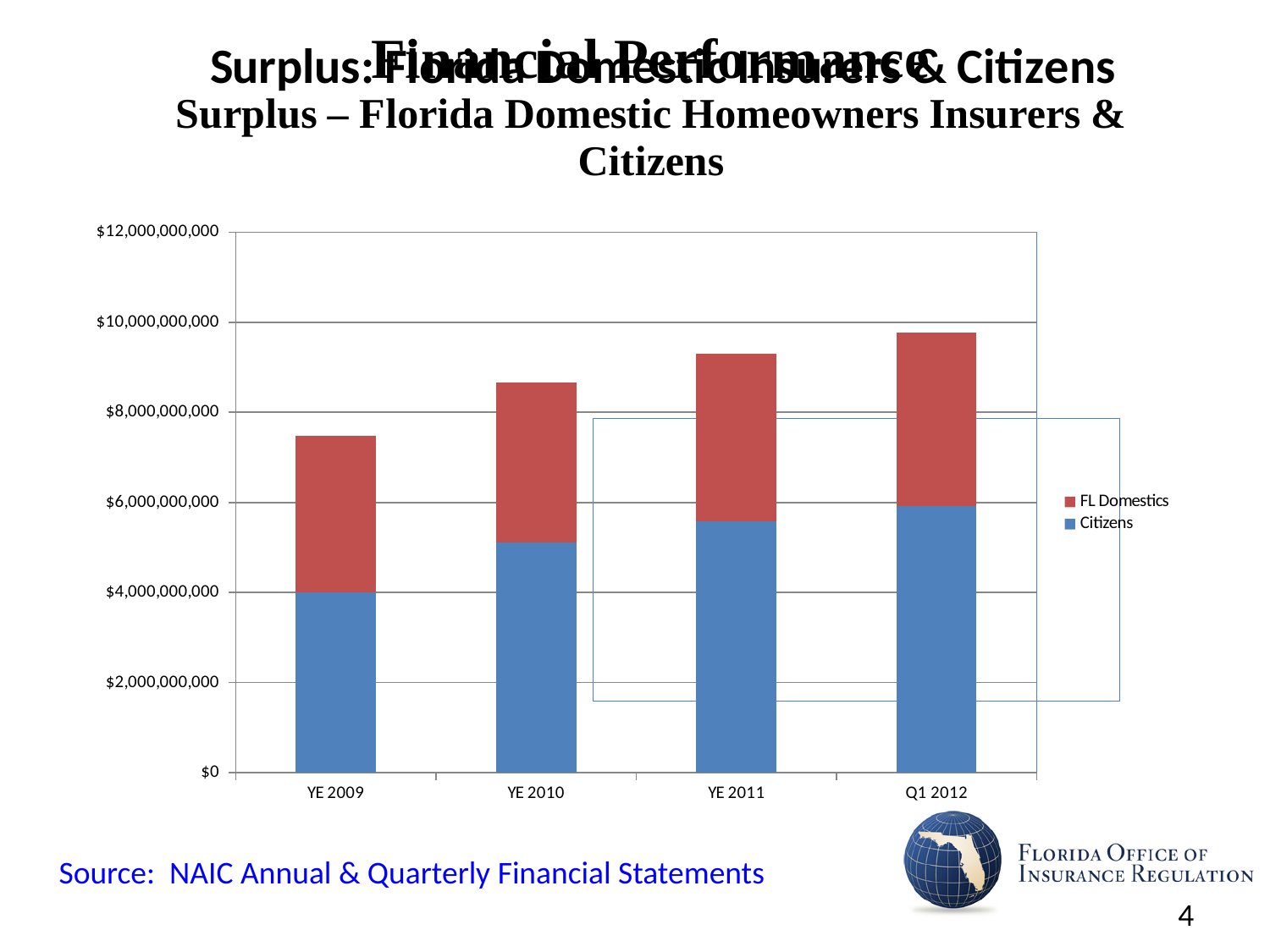
Do the total stacked bar heights rise or fall from YE 2009 to Q1 2012? rise Which series are listed in the chart's legend? FL Domestics and Citizens How many time periods are shown on the x axis of the chart? 4 Which period has the highest total stacked bar? Q1 2012 Is the total stacked bar for YE 2011 greater or less than $8,000,000,000? greater Which colour represents Citizens in the chart? blue Which period has the lowest total stacked bar? YE 2009 Which is larger, the Citizens value for YE 2010 or the Citizens value for YE 2009? YE 2010 How many series does the chart's legend list? 2 Is the total stacked bar for YE 2009 greater or less than $8,000,000,000? less What kind of chart is shown on the slide? stacked bar chart